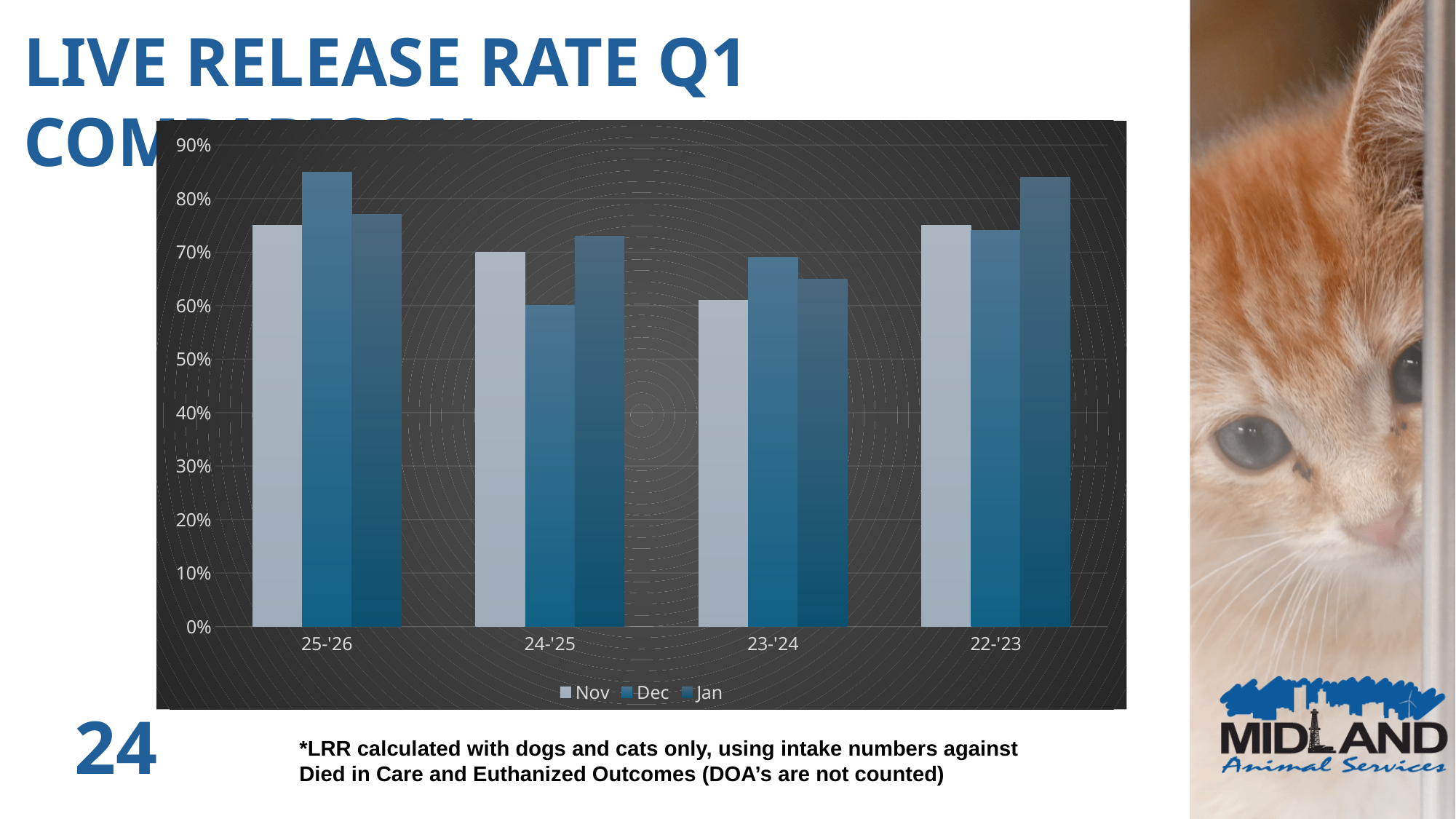
Which is larger for 24-'25, the Nov value or the Dec value? Nov Which series are listed in the legend? Nov, Dec, Jan Is the Nov value for 23-'24 greater or less than 70%? less Which year has the lowest Nov value? 23-'24 What kind of chart is shown on the slide? bar chart How many year categories are shown on the x axis? 4 Is the Dec value for 25-'26 greater or less than 80%? greater Which year has the highest Jan value? 22-'23 How many series does the legend list? 3 Which year has the lowest Dec value? 24-'25 Which year has the highest Dec value? 25-'26 Is the Jan value for 22-'23 greater or less than 80%? greater